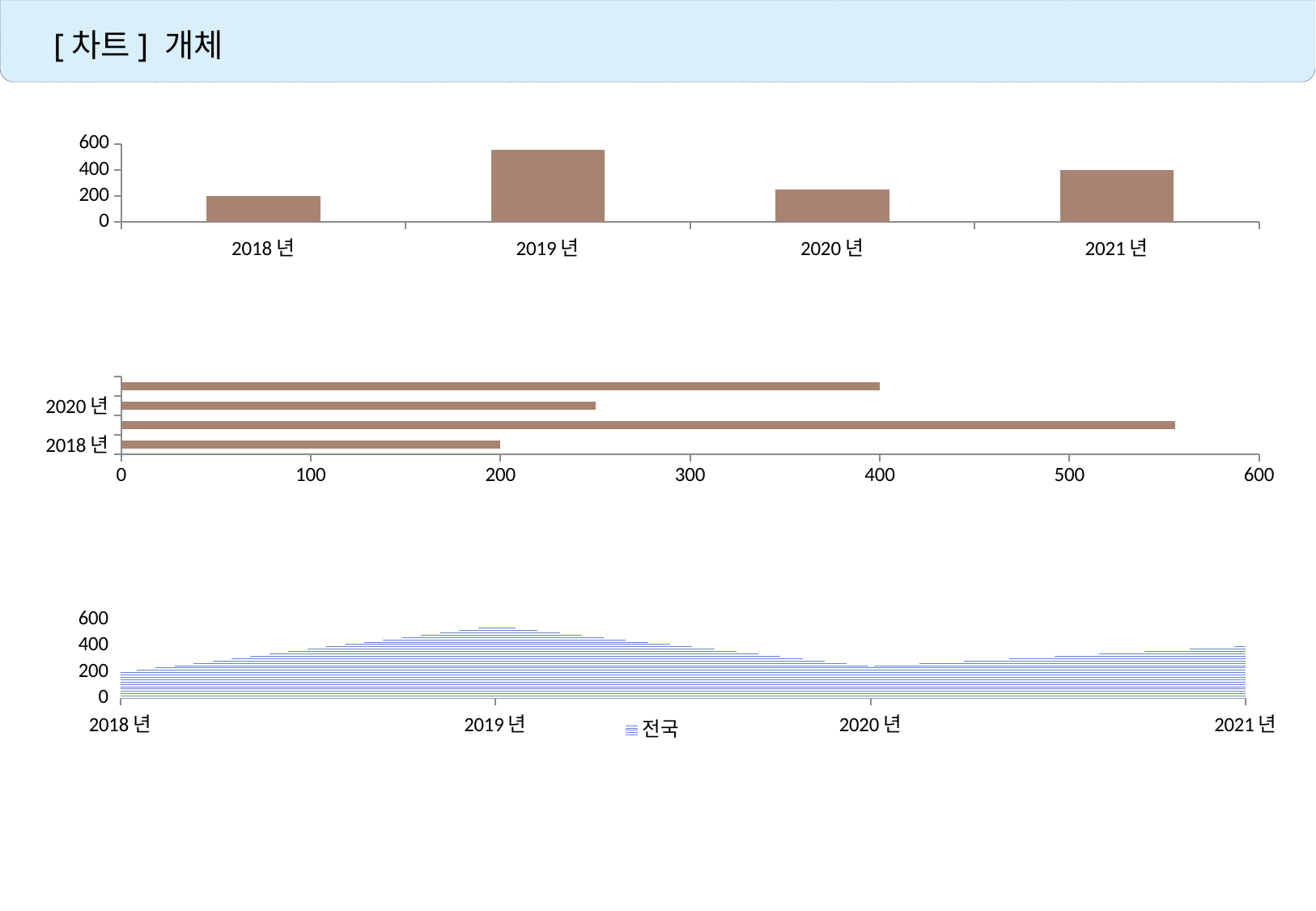
In the bottom chart, what is the name of the series shown in the legend? 전국 In the top chart, which is larger, the value for 2020 년 or the value for 2021 년? 2021 년 In the top chart, which year has the highest bar? 2019 년 In the middle chart, is the value for 2020 년 greater or less than 200? greater In the top chart, how many categories are shown on the x axis? 4 In the top chart, is the value for 2020 년 greater or less than 400? less What kind of chart is the middle chart on the slide? bar chart In the middle chart, what is the value for 2018 년? 200 In the top chart, is the value for 2019 년 greater or less than 400? greater In the top chart, which year has the lowest bar? 2018 년 What kind of chart is the top chart on the slide? bar chart In the bottom chart, how many series does the legend list? 1